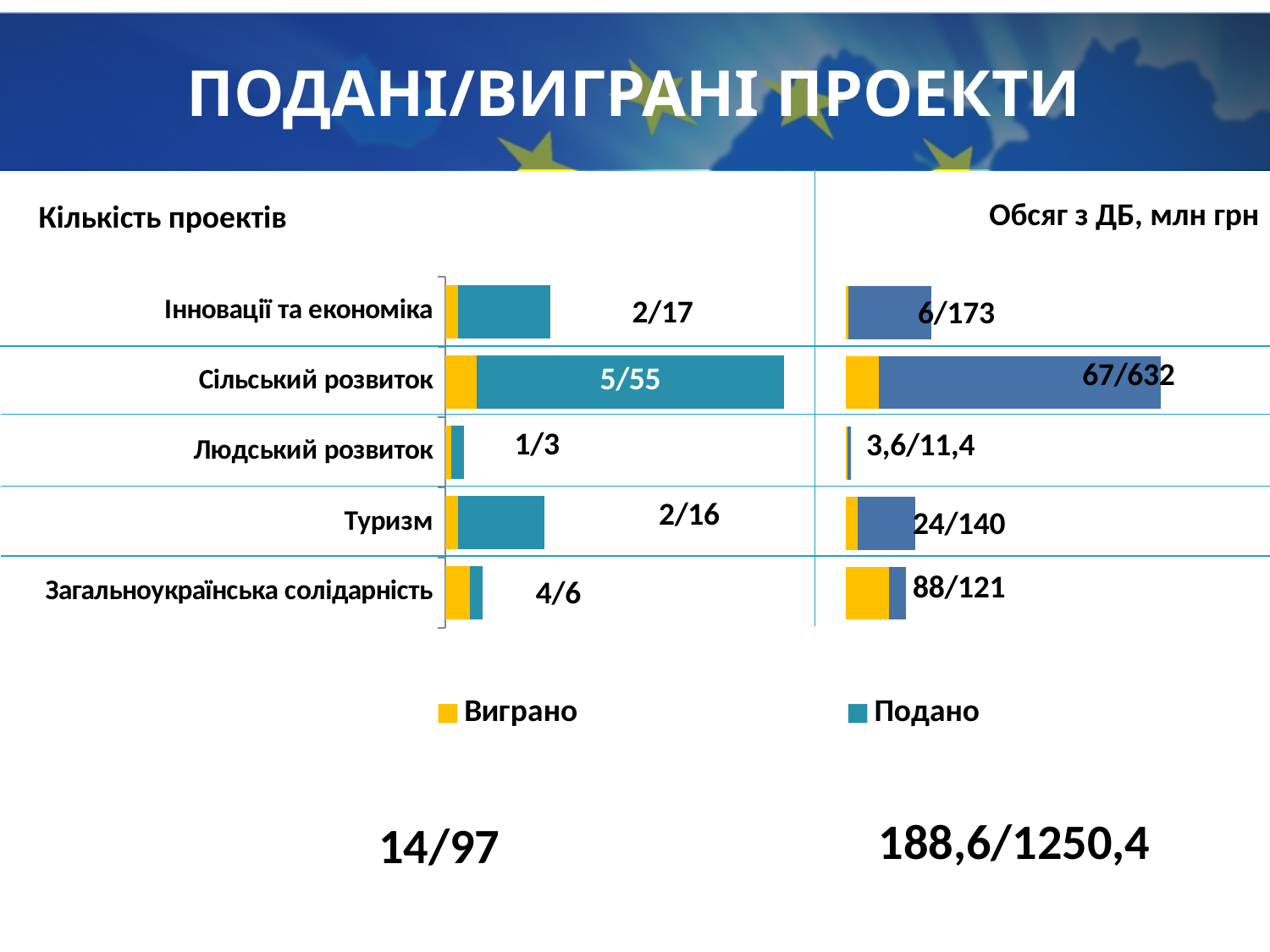
How many series does the legend list? 2 On the left chart (Кількість проектів), what label is shown for Сільський розвиток? 5/55 On the right chart (Обсяг з ДБ, млн грн), what label is shown for Людський розвиток? 3,6/11,4 On the right chart (Обсяг з ДБ, млн грн), what label is shown for Загальноукраїнська солідарність? 88/121 How many categories are shown on the left chart (Кількість проектів)? 5 On the left chart (Кількість проектів), what label is shown for Туризм? 2/16 On the right chart (Обсяг з ДБ, млн грн), which is larger: the submitted volume for Туризм or for Інновації та економіка? Інновації та економіка On the left chart (Кількість проектів), which category has the highest number of submitted (Подано) projects? Сільський розвиток What kind of chart is the left chart (Кількість проектів)? Bar chart On the right chart (Обсяг з ДБ, млн грн), which category has the lowest submitted (Подано) volume? Людський розвиток On the left chart (Кількість проектів), how many more projects were submitted for Сільський розвиток than for Інновації та економіка? 38 What total is printed below the right chart (Обсяг з ДБ, млн грн)? 188,6/1250,4